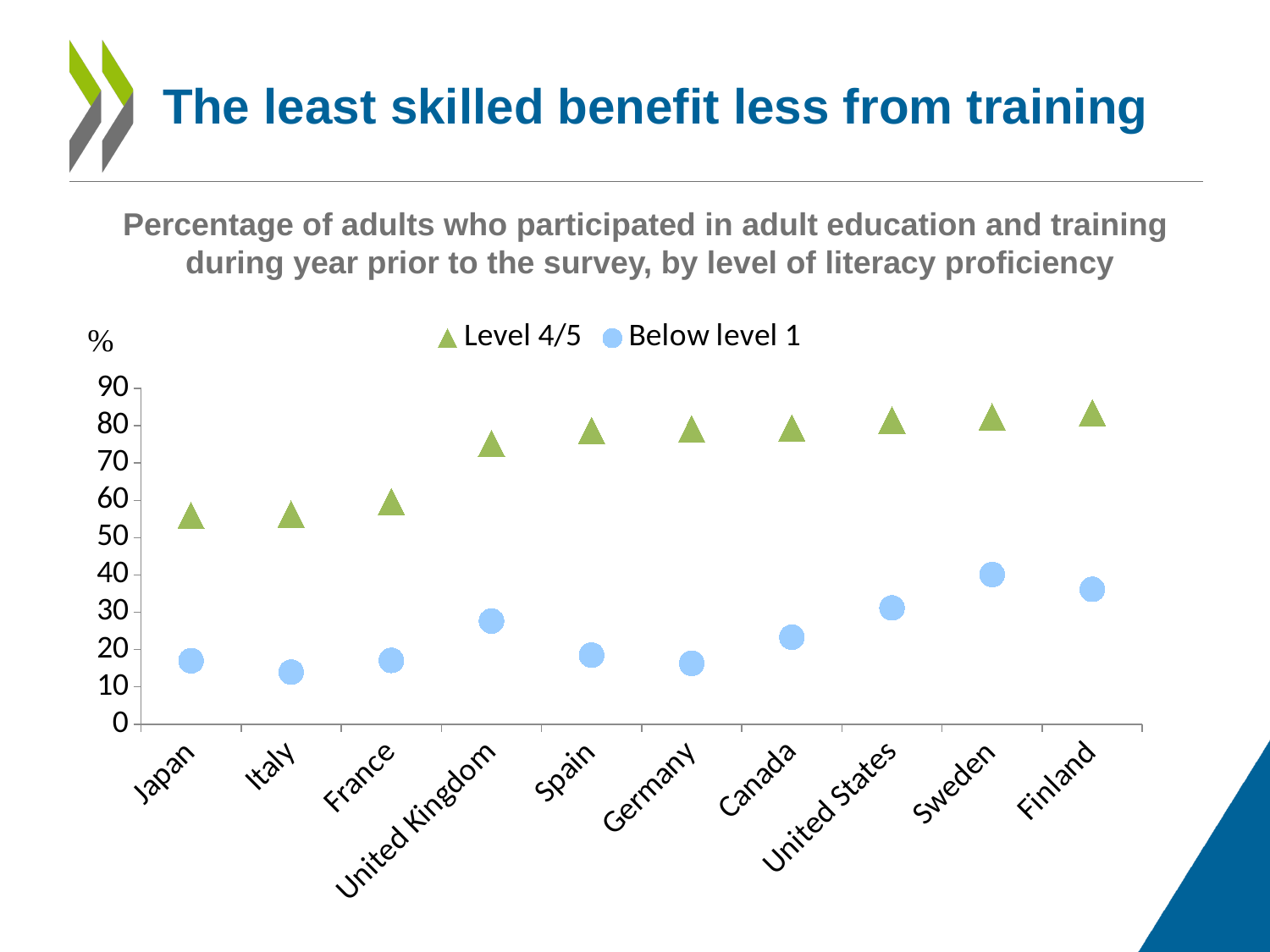
Is the Level 4/5 value for Finland greater or less than 80? greater Is the Below level 1 value for United States greater or less than 40? less Which series is shown with green triangle markers? Level 4/5 Which is larger, the Level 4/5 value for United Kingdom or the Level 4/5 value for Japan? United Kingdom What kind of chart is shown on the slide? Scatter chart Is the Level 4/5 value for Japan greater or less than 50? greater Which country has the highest Below level 1 value? Sweden Do the Level 4/5 values generally rise or fall from Japan to Finland along the x axis? rise What is the unit shown on the vertical axis of the chart? % How many countries are shown on the x axis of the chart? 10 How many series does the chart's legend list? 2